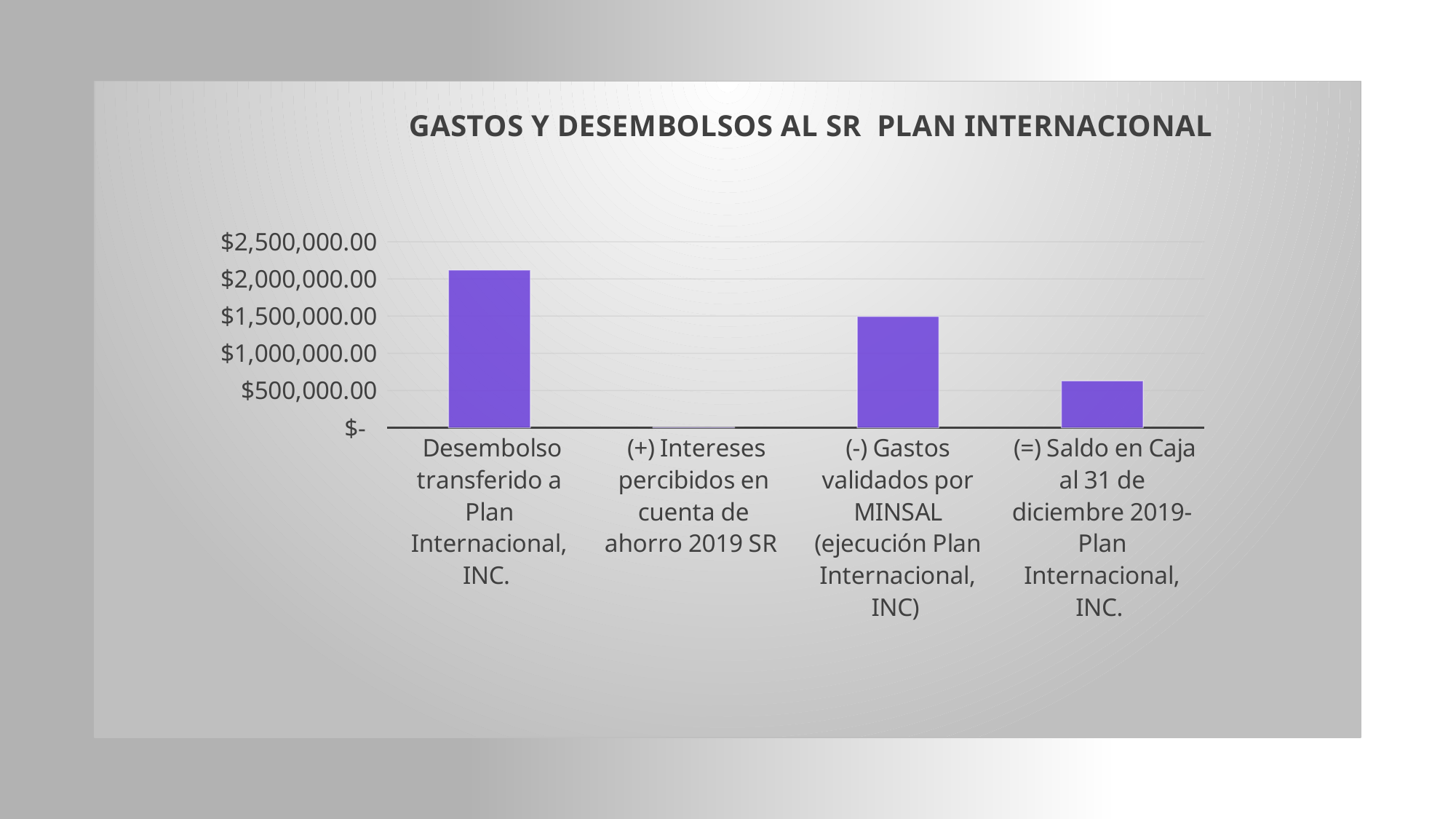
Which is larger: the value for "Desembolso transferido a Plan Internacional, INC." or the value for "(-) Gastos validados por MINSAL"? Desembolso transferido a Plan Internacional, INC. Is the value for "(+) Intereses percibidos en cuenta de ahorro 2019 SR" greater or less than $500,000.00? less How many categories are plotted on the chart? 4 Which is larger: the value for "(-) Gastos validados por MINSAL" or the value for "(=) Saldo en Caja al 31 de diciembre 2019"? (-) Gastos validados por MINSAL What is the title of the chart? GASTOS Y DESEMBOLSOS AL SR PLAN INTERNACIONAL Which category has the lowest value? (+) Intereses percibidos en cuenta de ahorro 2019 SR What kind of chart is shown on the slide? Bar chart Is the value for "(=) Saldo en Caja al 31 de diciembre 2019" greater or less than $500,000.00? greater Is the value for "(=) Saldo en Caja al 31 de diciembre 2019" greater or less than $1,000,000.00? less Which category has the highest value? Desembolso transferido a Plan Internacional, INC.